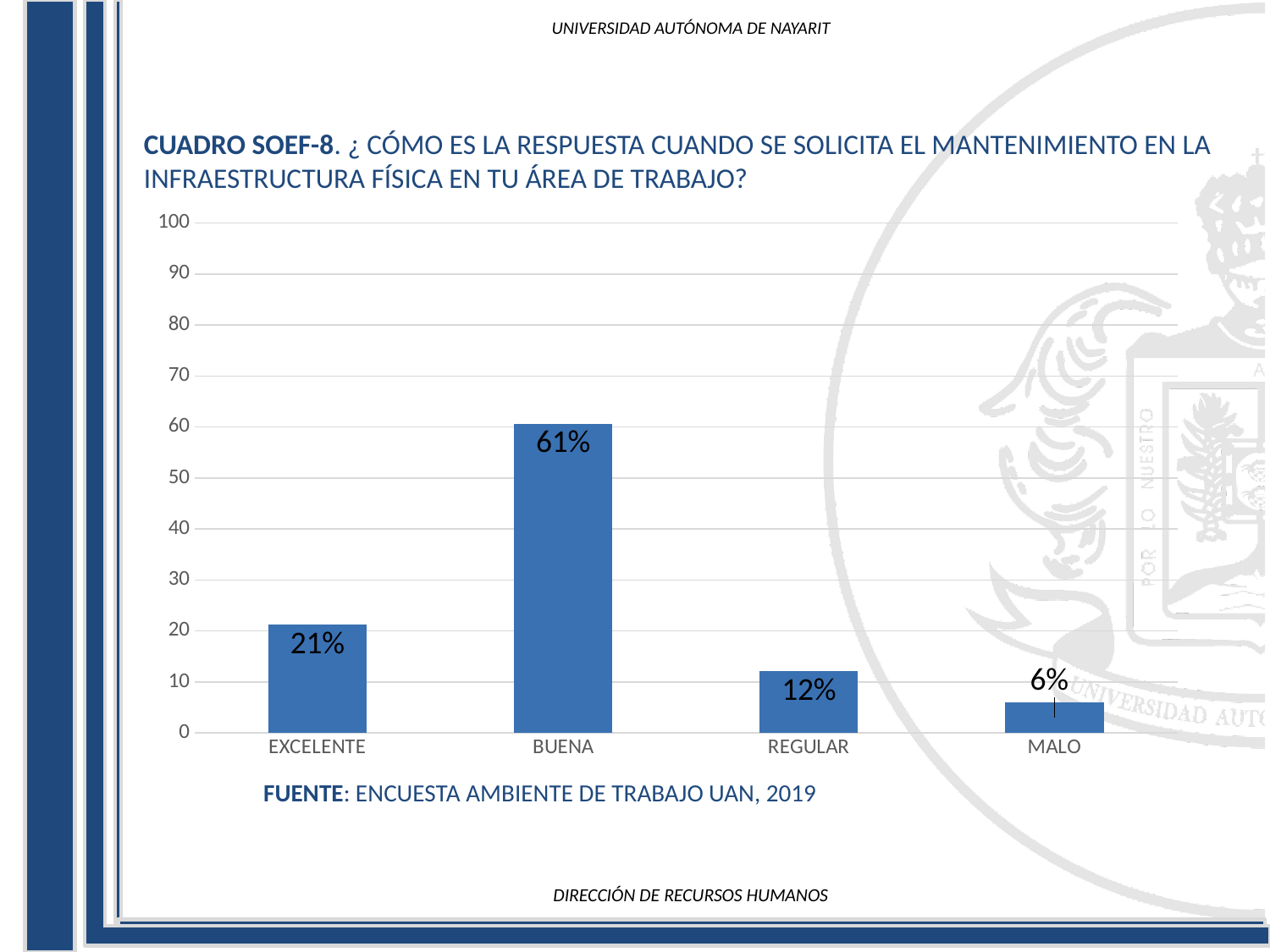
What is the value for BUENA? 61% Which category has the lowest value? MALO What kind of chart is shown on the slide? bar chart Which category has the highest value? BUENA What is the value for REGULAR? 12% What is the difference between the values for BUENA and EXCELENTE? 40% Which is larger, the value for EXCELENTE or the value for REGULAR? EXCELENTE What is the value for MALO? 6% What is the difference between the values for REGULAR and MALO? 6% What is the value for EXCELENTE? 21% How many categories are shown on the x axis? 4 Is the value for BUENA greater or less than 50? greater